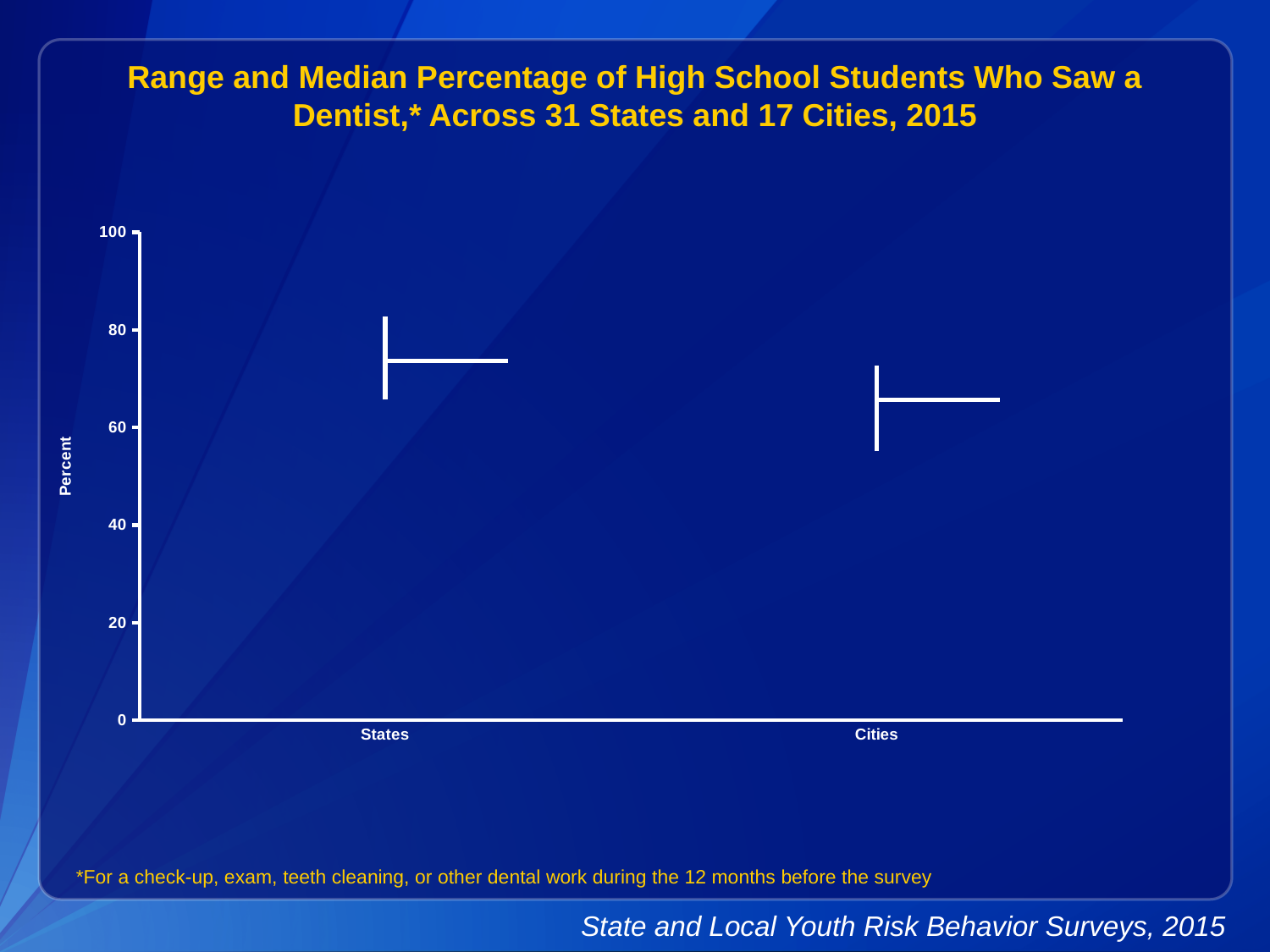
Is the median value for Cities greater or less than 80? less Is the median value for States greater or less than 60? greater What are the two categories shown on the x axis? States and Cities Is the median value for States greater or less than 80? less Which category has the lower median percentage? Cities Which category has the higher median percentage, States or Cities? States How many categories are shown on the x axis of the chart? 2 What is the maximum value shown on the y axis? 100 What is the label on the y axis of the chart? Percent